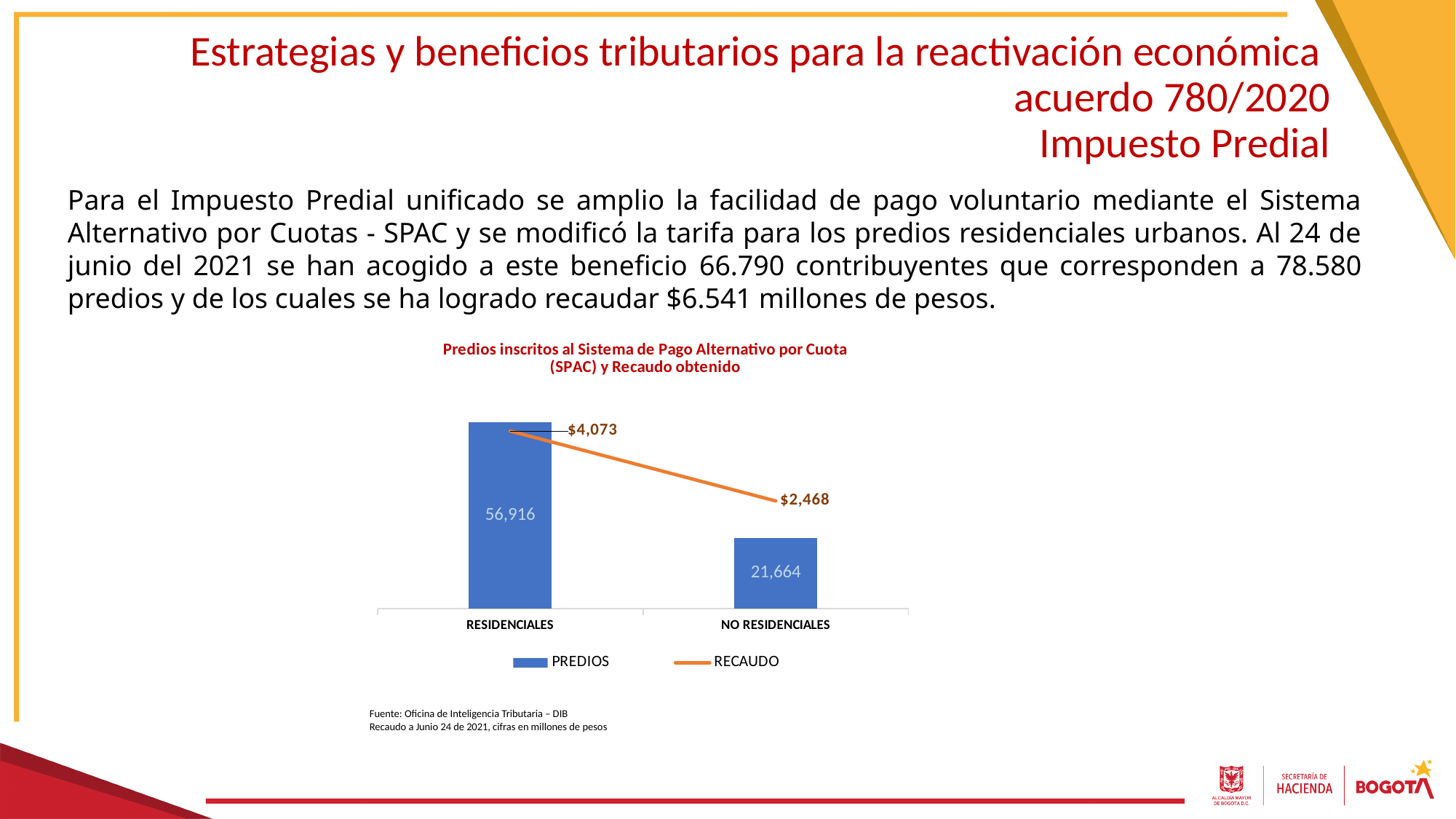
Which is larger, the PREDIOS value for RESIDENCIALES or for NO RESIDENCIALES? RESIDENCIALES What is the RECAUDO value for RESIDENCIALES? $4,073 How many series does the chart legend list? 2 What is the difference in PREDIOS between RESIDENCIALES and NO RESIDENCIALES? 35,252 What is the RECAUDO value for NO RESIDENCIALES? $2,468 What is the PREDIOS value for NO RESIDENCIALES? 21,664 Which series is drawn as a line in the chart? RECAUDO How many categories are shown on the x axis of the chart? 2 Which category has the highest PREDIOS value? RESIDENCIALES What is the difference in RECAUDO between RESIDENCIALES and NO RESIDENCIALES? $1,605 Which category has the lowest RECAUDO value? NO RESIDENCIALES What is the PREDIOS value for RESIDENCIALES? 56,916